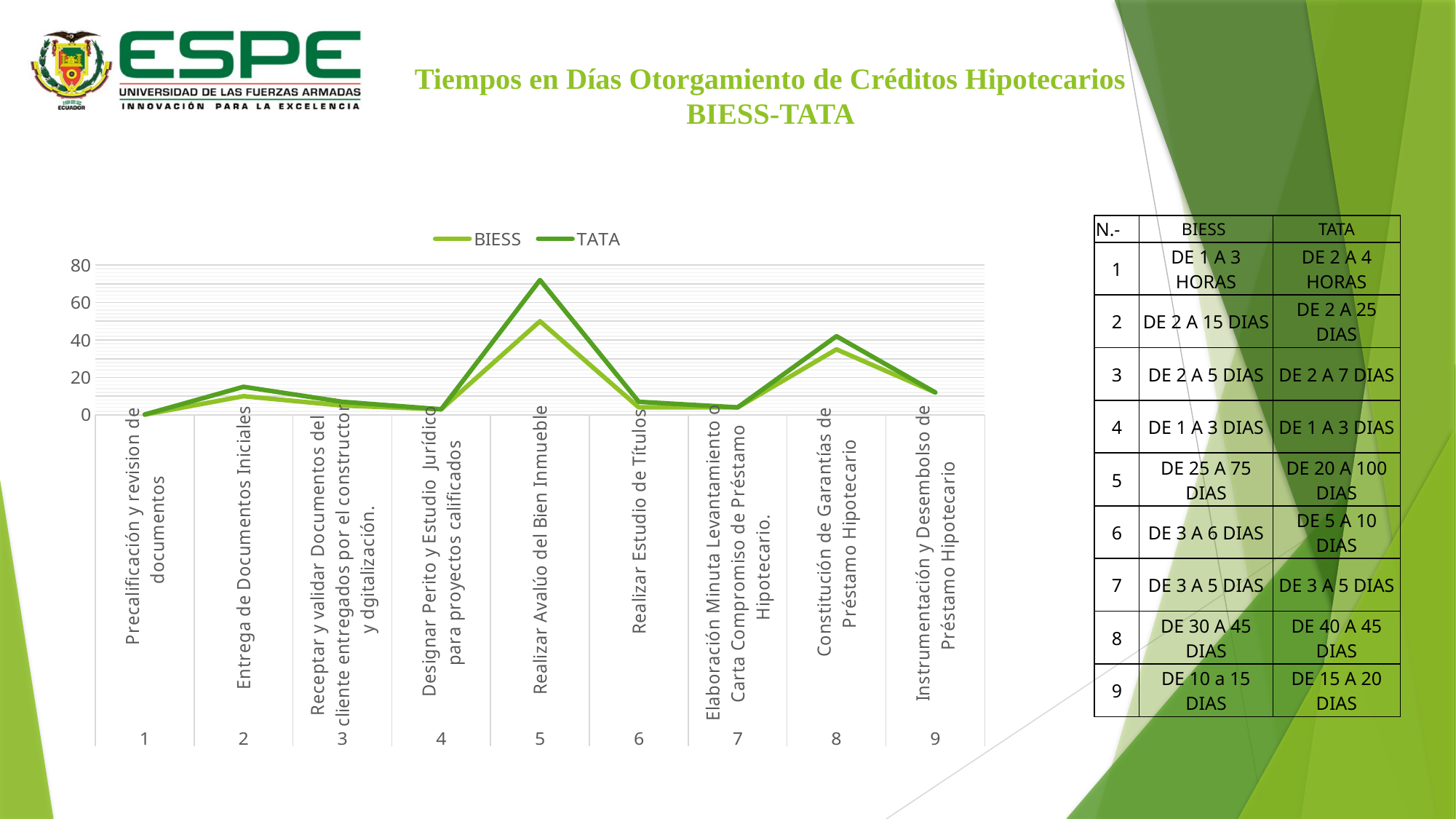
At 'Realizar Avalúo del Bien Inmueble', which series has the larger value, BIESS or TATA? TATA Is the TATA value for 'Realizar Avalúo del Bien Inmueble' greater or less than 60? greater What are the two series named in the chart legend? BIESS and TATA How many categories (steps) are plotted along the x axis of the chart? 9 Is the BIESS value for 'Realizar Avalúo del Bien Inmueble' greater or less than 60? less Do the values of both series rise or fall from category 5 to category 6? fall For which category does the BIESS series reach its highest value? Realizar Avalúo del Bien Inmueble At 'Entrega de Documentos Iniciales', which series has the larger value, BIESS or TATA? TATA What kind of chart is shown on the slide? line chart For which category does the TATA series reach its highest value? Realizar Avalúo del Bien Inmueble Is the TATA value for 'Constitución de Garantías de Préstamo Hipotecario' greater or less than 20? greater How many series does the chart legend list? 2